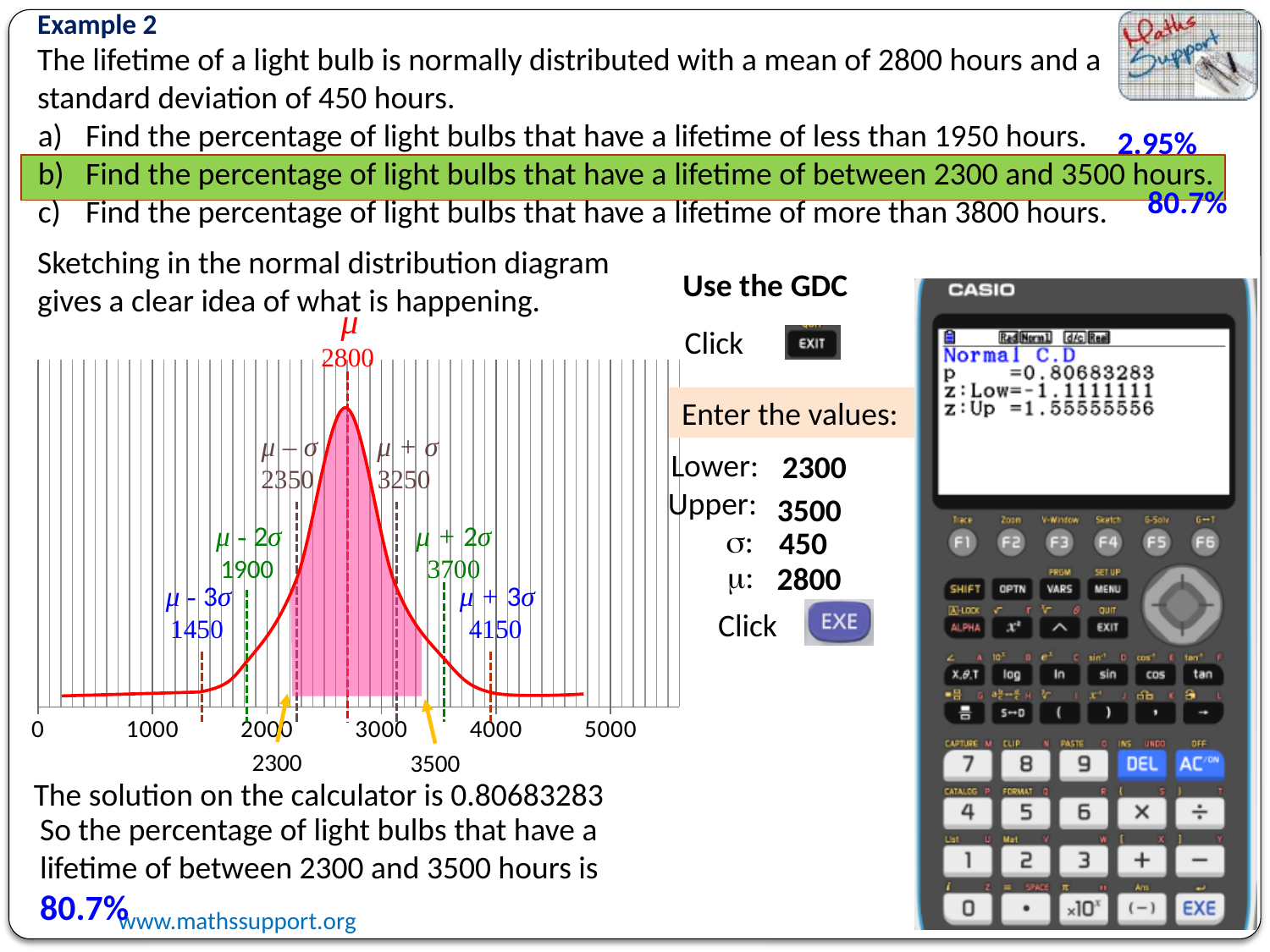
On the normal distribution diagram, what value is labelled at the mean μ? 2800 How many tick labels are shown on the x axis of the normal distribution diagram? 6 On the normal distribution diagram, is the value labelled at μ − 2σ greater or less than 2000? less What colour is the shaded region under the curve on the normal distribution diagram? Pink On the normal distribution diagram, which is larger, the value at μ + 3σ or the value at μ + 2σ? μ + 3σ On the normal distribution diagram, what is the upper boundary value of the shaded region? 3500 What is the largest tick label shown on the x axis of the normal distribution diagram? 5000 On the normal distribution diagram, what is the difference between the values labelled at μ + σ and μ − σ? 900 On the normal distribution diagram, what value is labelled at μ + 2σ? 3700 On the normal distribution diagram, what value is labelled at μ + σ? 3250 On the normal distribution diagram, what is the lower boundary value of the shaded region? 2300 On the normal distribution diagram, what value is labelled at μ − 3σ? 1450